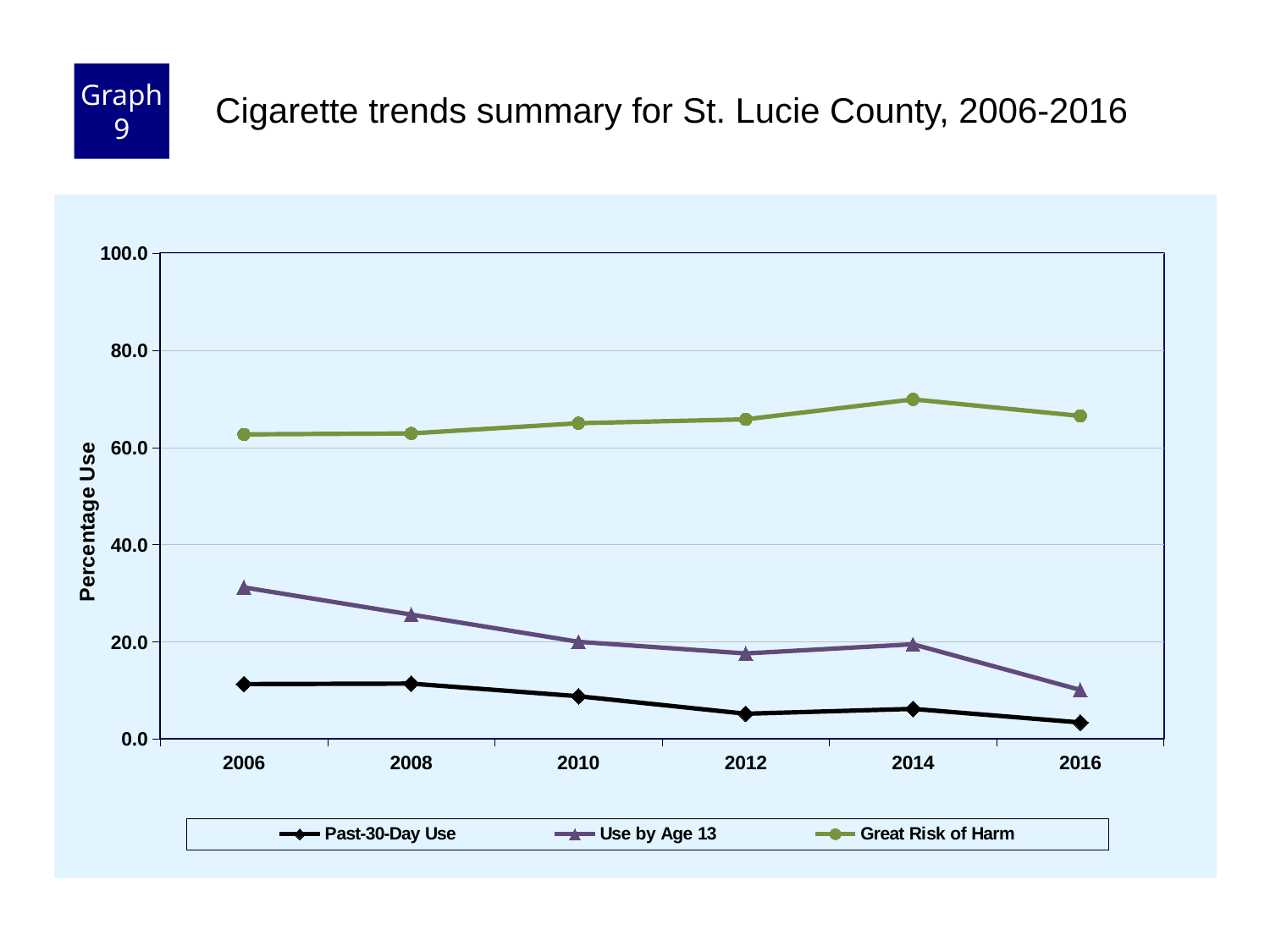
Is the value for Past-30-Day Use in 2012 greater or less than 20.0? less Is the value for Use by Age 13 in 2016 greater or less than 20.0? less In 2006, which is larger: Use by Age 13 or Past-30-Day Use? Use by Age 13 In which year is Great Risk of Harm highest? 2014 What is the title of the chart? Cigarette trends summary for St. Lucie County, 2006-2016 Does Use by Age 13 generally rise or fall from 2006 to 2016? fall In which year is Use by Age 13 lowest? 2016 Is the value for Use by Age 13 in 2006 greater or less than 20.0? greater How many years are plotted along the x axis? 6 What kind of chart is shown on the slide? line chart How many series does the legend list? 3